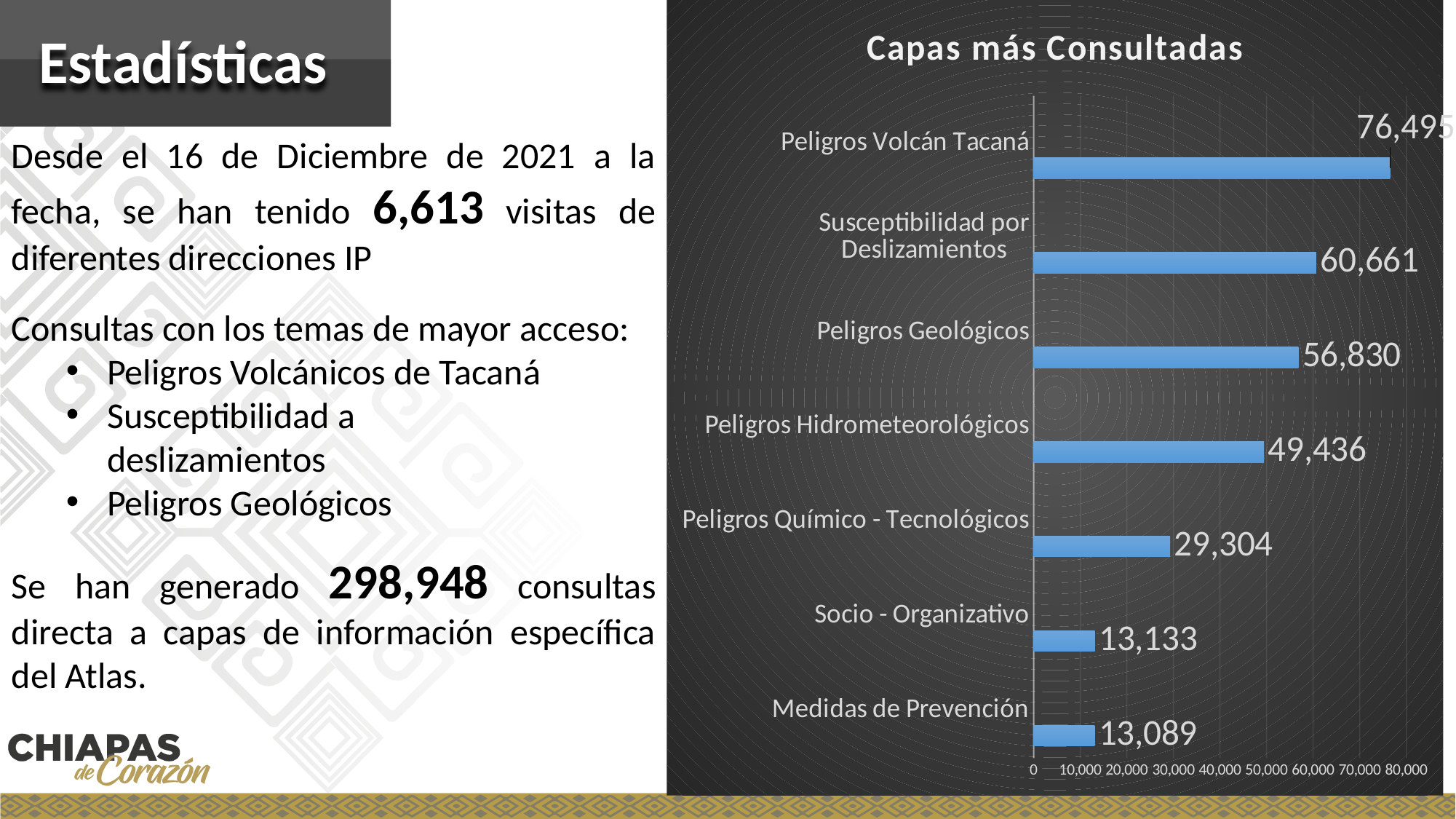
How many categories are shown in the chart? 7 Which is larger, Peligros Geológicos or Peligros Químico - Tecnológicos? Peligros Geológicos Is the value for Peligros Geológicos greater or less than 50,000? greater What is the difference between Peligros Volcán Tacaná and Susceptibilidad por Deslizamientos? 15,834 Which category has the highest value? Peligros Volcán Tacaná What is the value for Peligros Volcán Tacaná? 76,495 Which category has the lowest value? Medidas de Prevención What is the value for Peligros Hidrometeorológicos? 49,436 What type of chart is shown on the slide? Bar chart What is the title of the chart? Capas más Consultadas What is the value for Socio - Organizativo? 13,133 What is the value for Susceptibilidad por Deslizamientos? 60,661